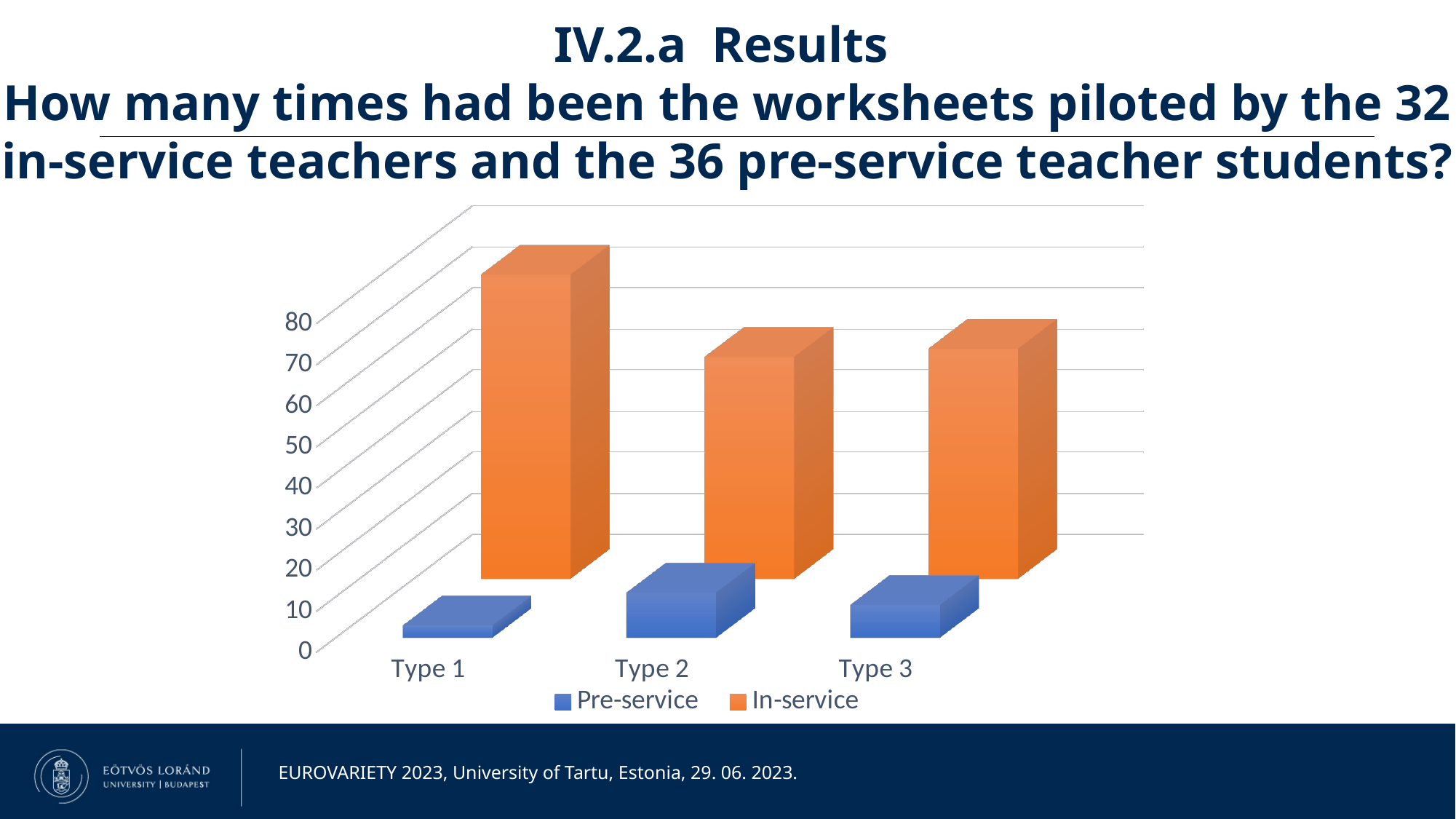
Which series is shown in blue in the chart? Pre-service Which series is shown in orange in the chart? In-service Is the Pre-service value for Type 1 greater or less than 10? less For Type 3, which series has the larger value, Pre-service or In-service? In-service For which type is the Pre-service value lowest? Type 1 How many categories are shown on the x axis of the chart? 3 What kind of chart is shown on the slide? Bar chart How many series does the chart's legend list? 2 Is the Pre-service value for Type 2 greater or less than 20? less For which type is the In-service value highest? Type 1